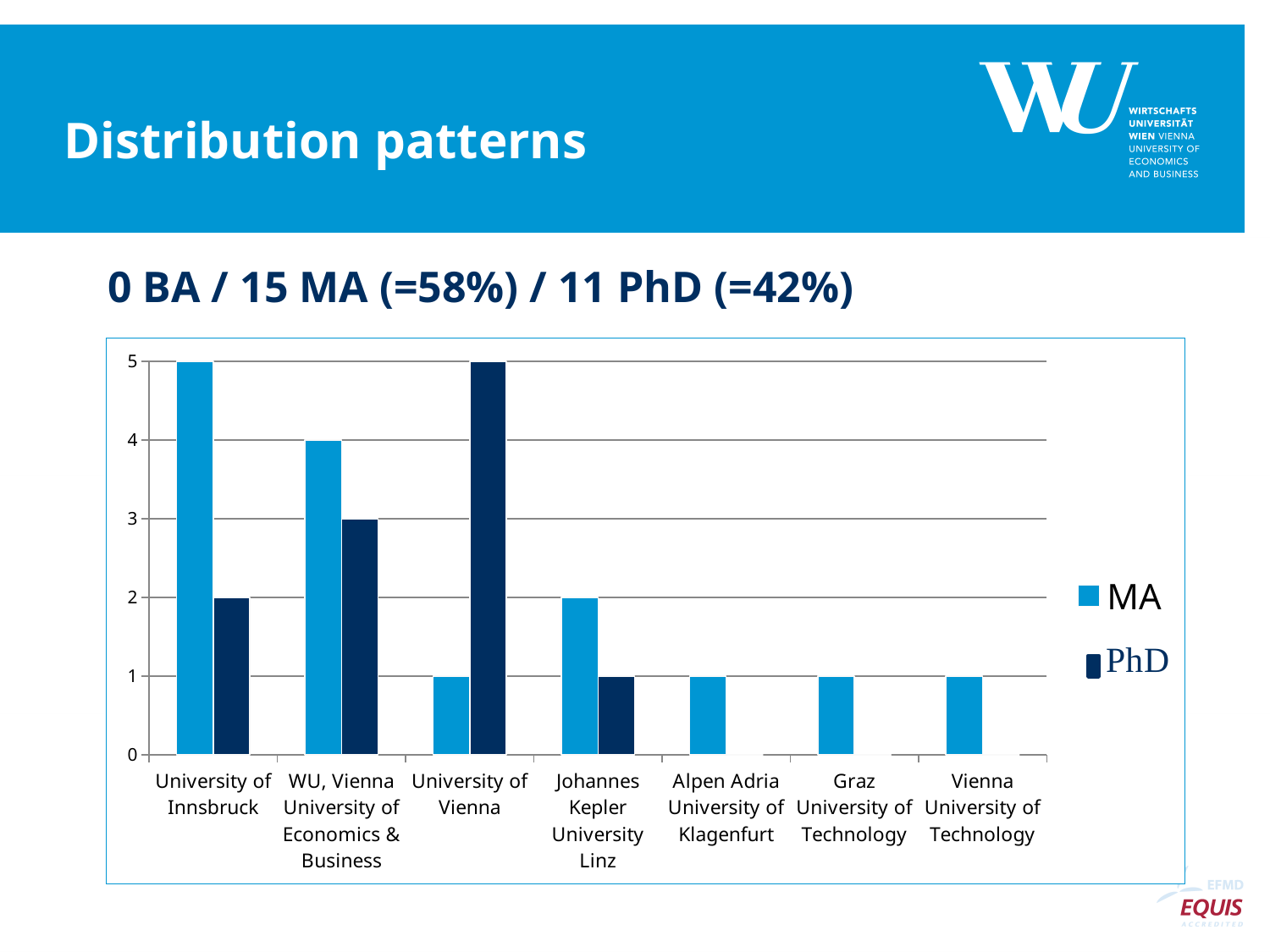
Which series is shown in dark blue in the legend? PhD How many universities are shown on the x axis? 7 What type of chart is shown on the slide? bar chart What is the PhD value for WU, Vienna University of Economics & Business? 3 Which university has the highest PhD value? University of Vienna What is the difference between the MA and PhD values for University of Innsbruck? 3 What is the PhD value for University of Vienna? 5 Which university has the highest MA value? University of Innsbruck What is the MA value for University of Innsbruck? 5 How many series does the legend list? 2 What is the MA value for Johannes Kepler University Linz? 2 Which is larger for WU, Vienna University of Economics & Business: the MA value or the PhD value? MA